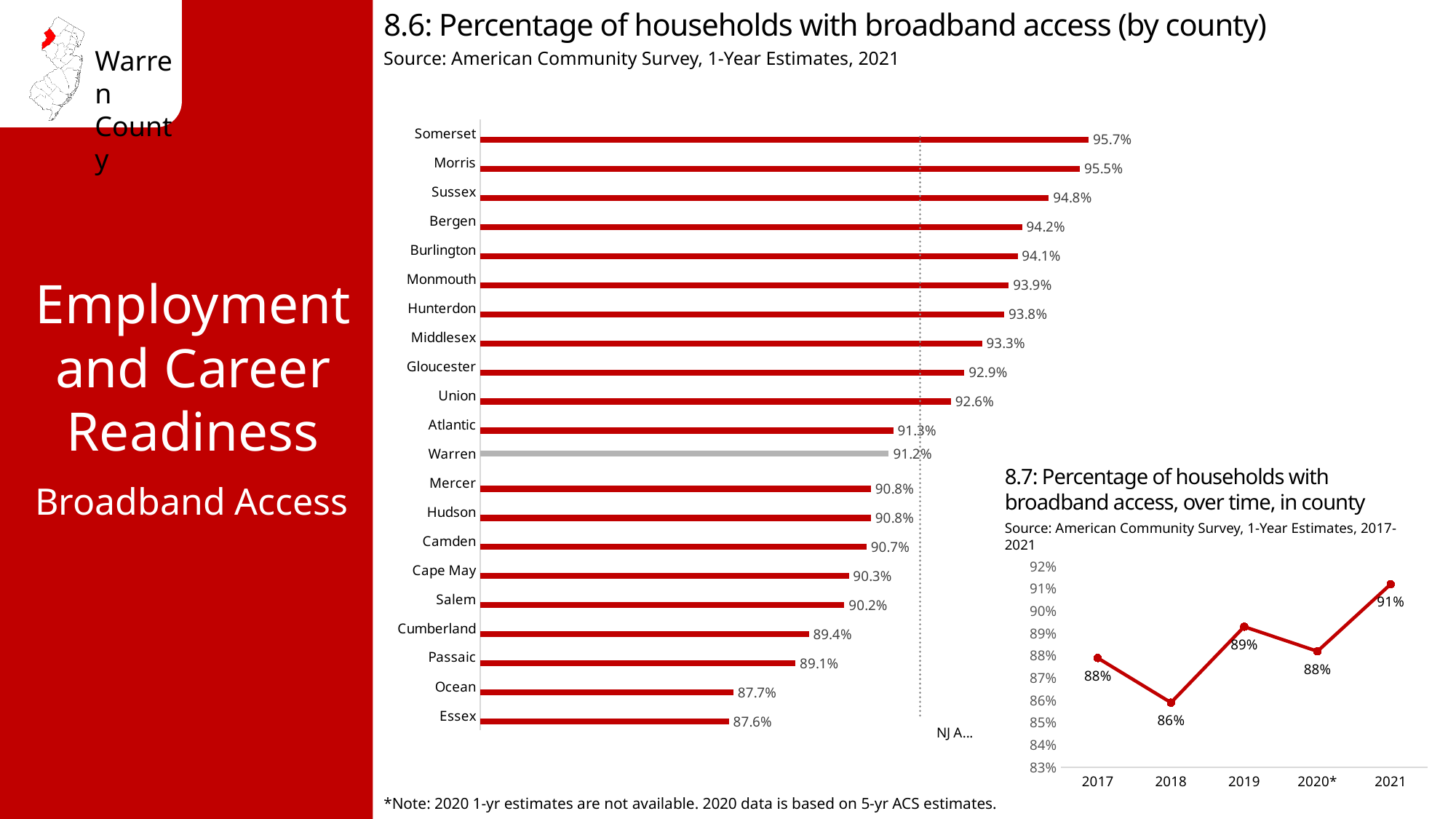
In chart 8.6, what is the percentage of households with broadband access in Warren County? 91.2% In chart 8.6, which county has the highest percentage of households with broadband access? Somerset In chart 8.7, what was the percentage of households with broadband access in 2018? 86% In chart 8.6, what is the value for Cumberland? 89.4% In chart 8.7, how many years are plotted? 5 In chart 8.6, how many counties are shown? 21 In chart 8.7, which year has the highest percentage of households with broadband access? 2021 In chart 8.6, which county has a higher percentage of households with broadband access, Bergen or Passaic? Bergen In chart 8.6, what is the difference between Somerset's and Essex's percentages? 8.1% What kind of chart is chart 8.6? Bar chart In chart 8.7, what is the difference between the 2021 and 2017 values? 3% In chart 8.6, which county has the lowest percentage of households with broadband access? Essex